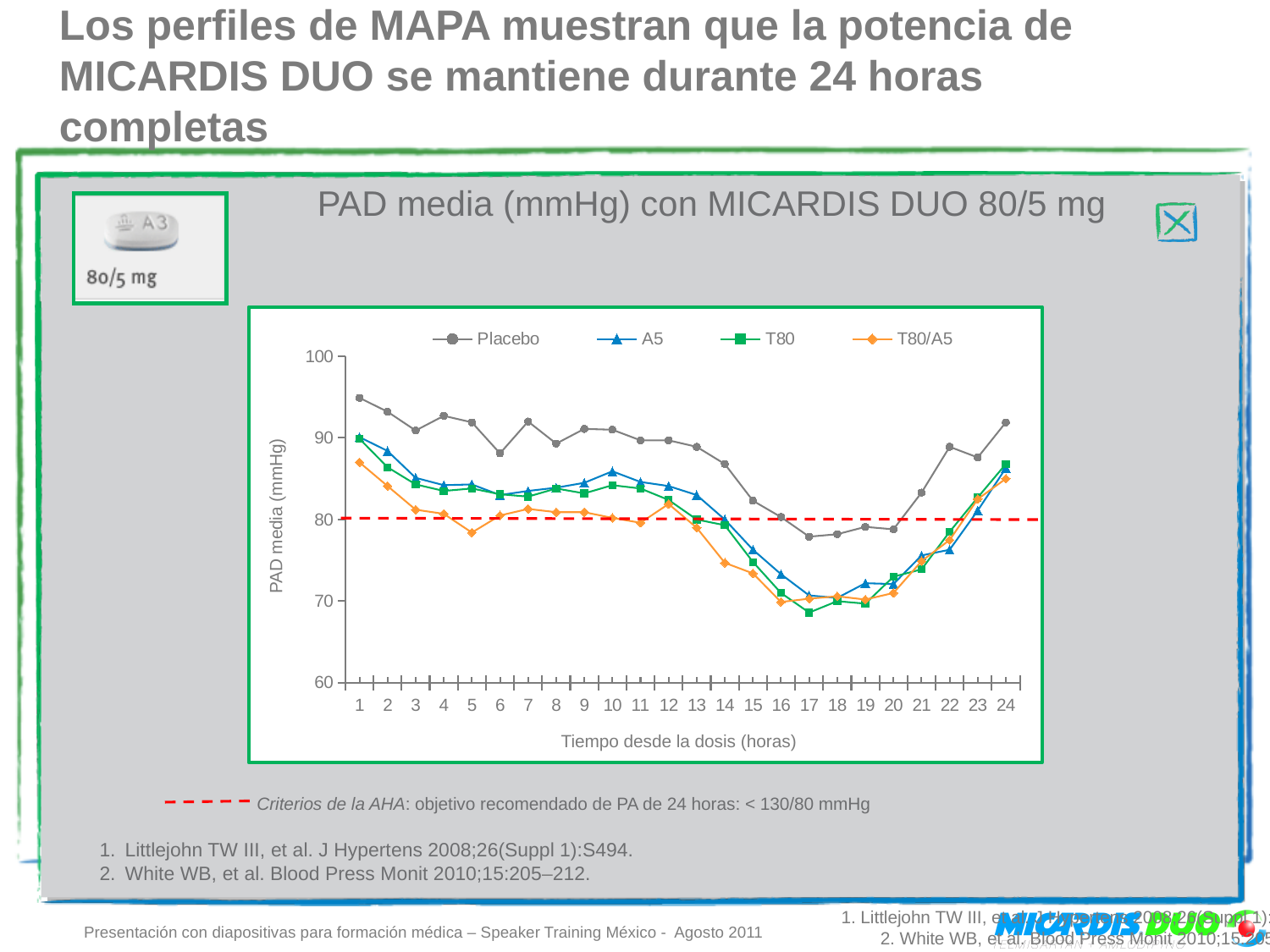
Which series has the highest value at hour 1? Placebo Is the Placebo value at hour 24 greater or less than 90? greater Is the Placebo value at hour 1 greater or less than 90? greater Which series has the lowest value at hour 5? T80/A5 Does the T80/A5 line rise or fall from hour 1 to hour 17? fall What kind of chart is shown on the slide? line chart At hour 1, which is higher: Placebo or T80/A5? Placebo Is the T80/A5 value at hour 17 greater or less than 80? less How many series does the legend list? 4 How many time points (hours) are shown along the x axis? 24 Does the Placebo line rise or fall from hour 17 to hour 24? rise What is the title of the chart? PAD media (mmHg) con MICARDIS DUO 80/5 mg